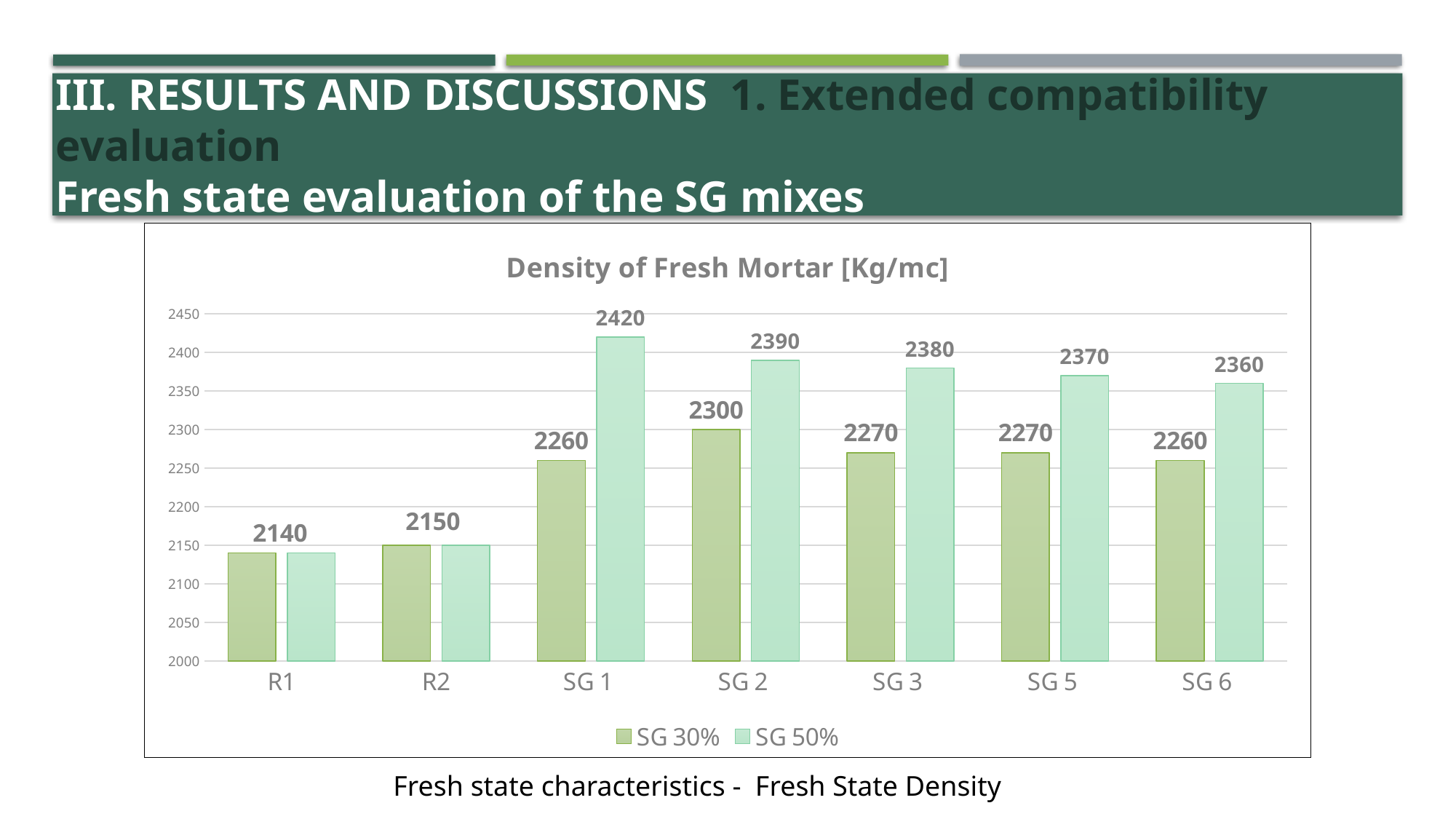
What is the difference between the SG 50% and SG 30% values for SG 1? 160 What kind of chart is shown on the slide? bar chart Which category has the highest SG 50% value? SG 1 How many series does the legend list? 2 Do the SG 50% values rise or fall from SG 1 to SG 6? fall What is the value of the SG 50% bar for SG 6? 2360 What is the value of the SG 50% bar for SG 1? 2420 How many categories are shown on the x axis? 7 What is the value of the SG 30% bar for SG 2? 2300 Is the SG 50% value for R1 greater or less than 2200? less Which is larger: the SG 50% value for SG 3 or the SG 50% value for SG 5? SG 3 Which category has the lowest density values overall? R1